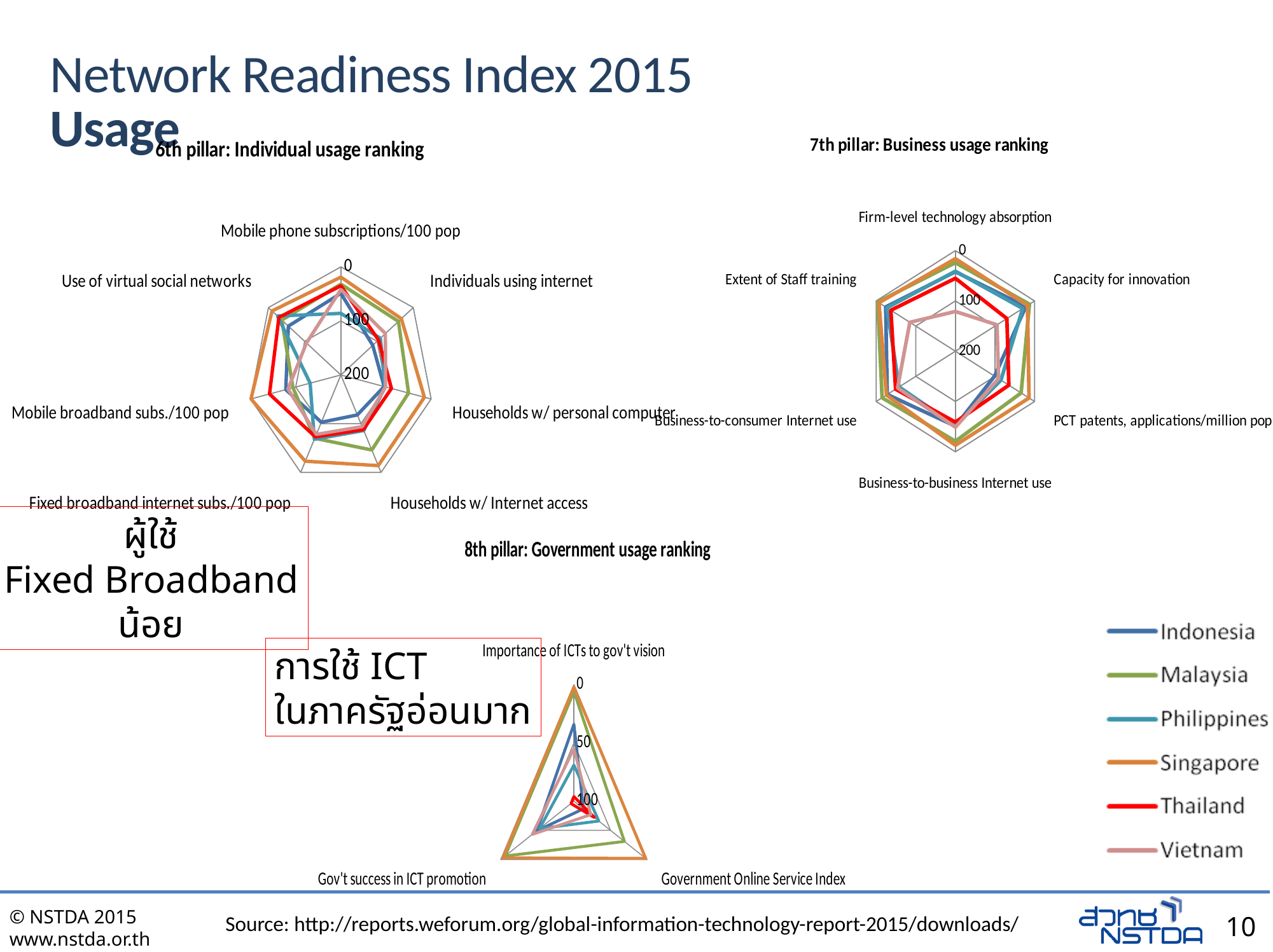
In the '8th pillar: Government usage ranking' chart, is the value for Thailand on Government Online Service Index greater or less than 50? greater Which series is drawn in red in the charts? Thailand In the '8th pillar: Government usage ranking' chart, is the value for Singapore on Importance of ICTs to gov't vision greater or less than 50? less In the '7th pillar: Business usage ranking' chart, is the value for Singapore on Firm-level technology absorption greater or less than 100? less How many categories (axes) does the '8th pillar: Government usage ranking' chart have? 3 How many categories (axes) does the '7th pillar: Business usage ranking' chart have? 6 How many series does the legend list? 6 What kind of chart is the '6th pillar: Individual usage ranking' chart? Radar chart What is the title of the chart at the bottom of the slide? 8th pillar: Government usage ranking How many categories (axes) does the '6th pillar: Individual usage ranking' chart have? 7